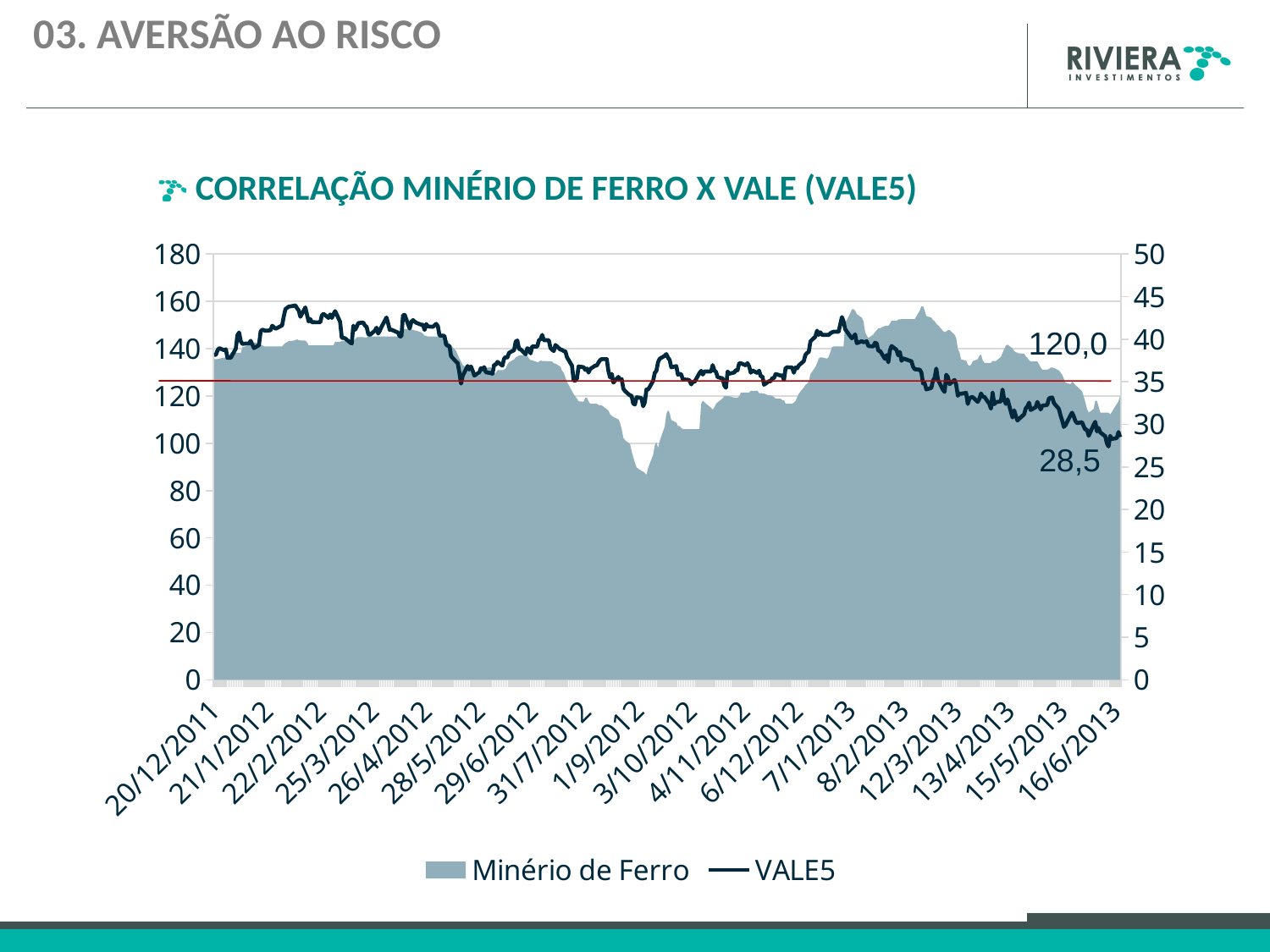
Which series are listed in the legend? Minério de Ferro and VALE5 Is the value for Minério de Ferro at 20/12/2011 greater or less than 120? greater How many series does the legend list? 2 What is the data label shown for Minério de Ferro at the end of the series? 120,0 Is the value for Minério de Ferro around 8/2/2013 greater or less than 140? greater What kind of chart is shown on the slide? Area and line chart Is the value for Minério de Ferro around 1/9/2012 greater or less than 100? less What is the title of the chart? CORRELAÇÃO MINÉRIO DE FERRO X VALE (VALE5) What is the data label shown for VALE5 at the end of the series? 28,5 Does the VALE5 line rise or fall between 7/1/2013 and 16/6/2013? fall